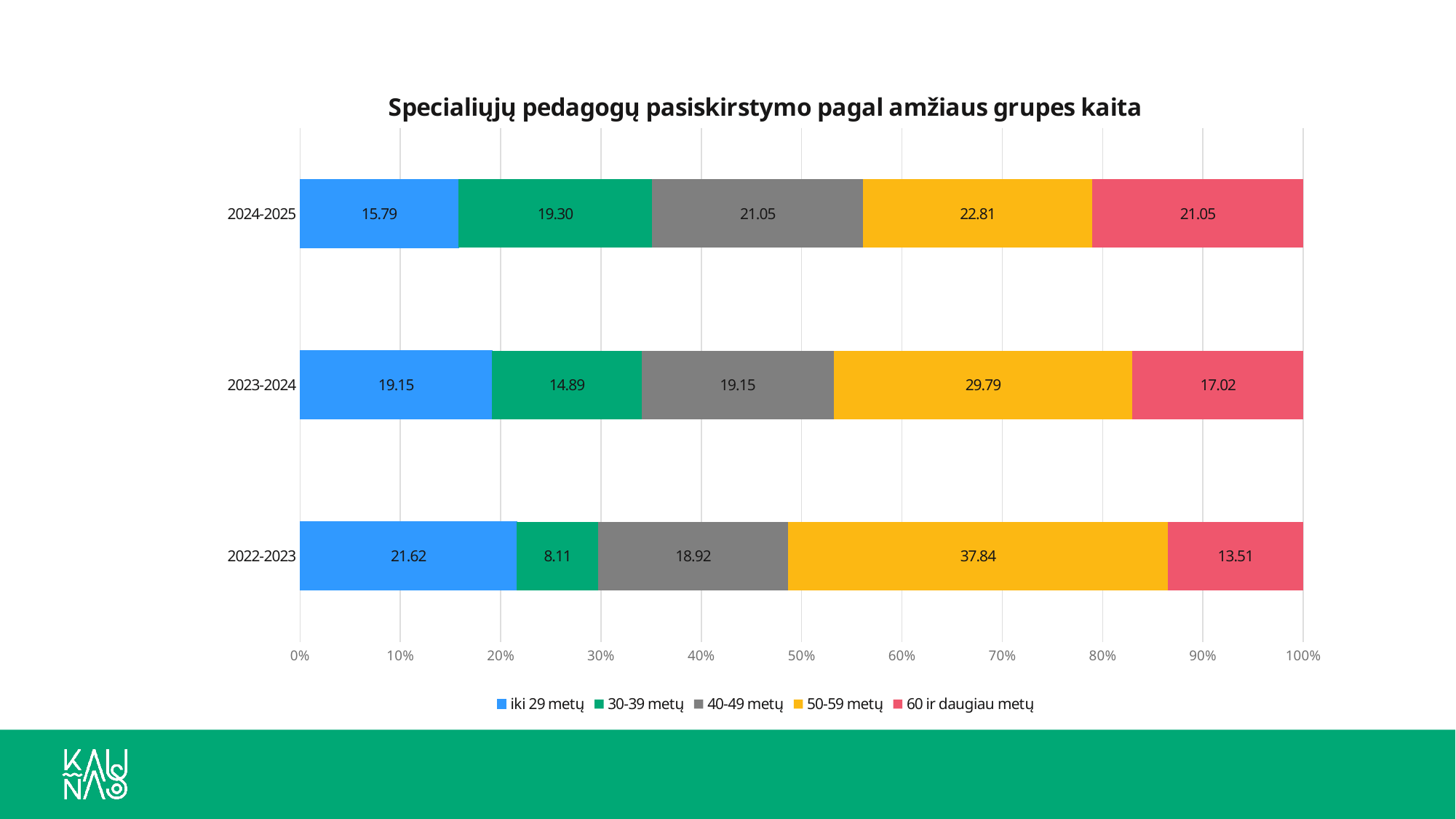
How many series does the legend list? 5 What is the value for the 30-39 metų series in 2022-2023? 8.11 In which year is the value for the 50-59 metų series highest? 2022-2023 What is the difference between the 50-59 metų value and the 60 ir daugiau metų value in 2023-2024? 12.77 What is the value for the 50-59 metų series in 2024-2025? 22.81 In which year is the value for the iki 29 metų series lowest? 2024-2025 Does the value for the 30-39 metų series rise or fall from 2022-2023 to 2024-2025? Rise In 2022-2023, which is larger: the iki 29 metų value or the 40-49 metų value? iki 29 metų What is the title of the chart? Specialiųjų pedagogų pasiskirstymo pagal amžiaus grupes kaita What is the value for the 60 ir daugiau metų series in 2023-2024? 17.02 What kind of chart is shown on the slide? Stacked bar chart How many year categories are shown on the chart? 3